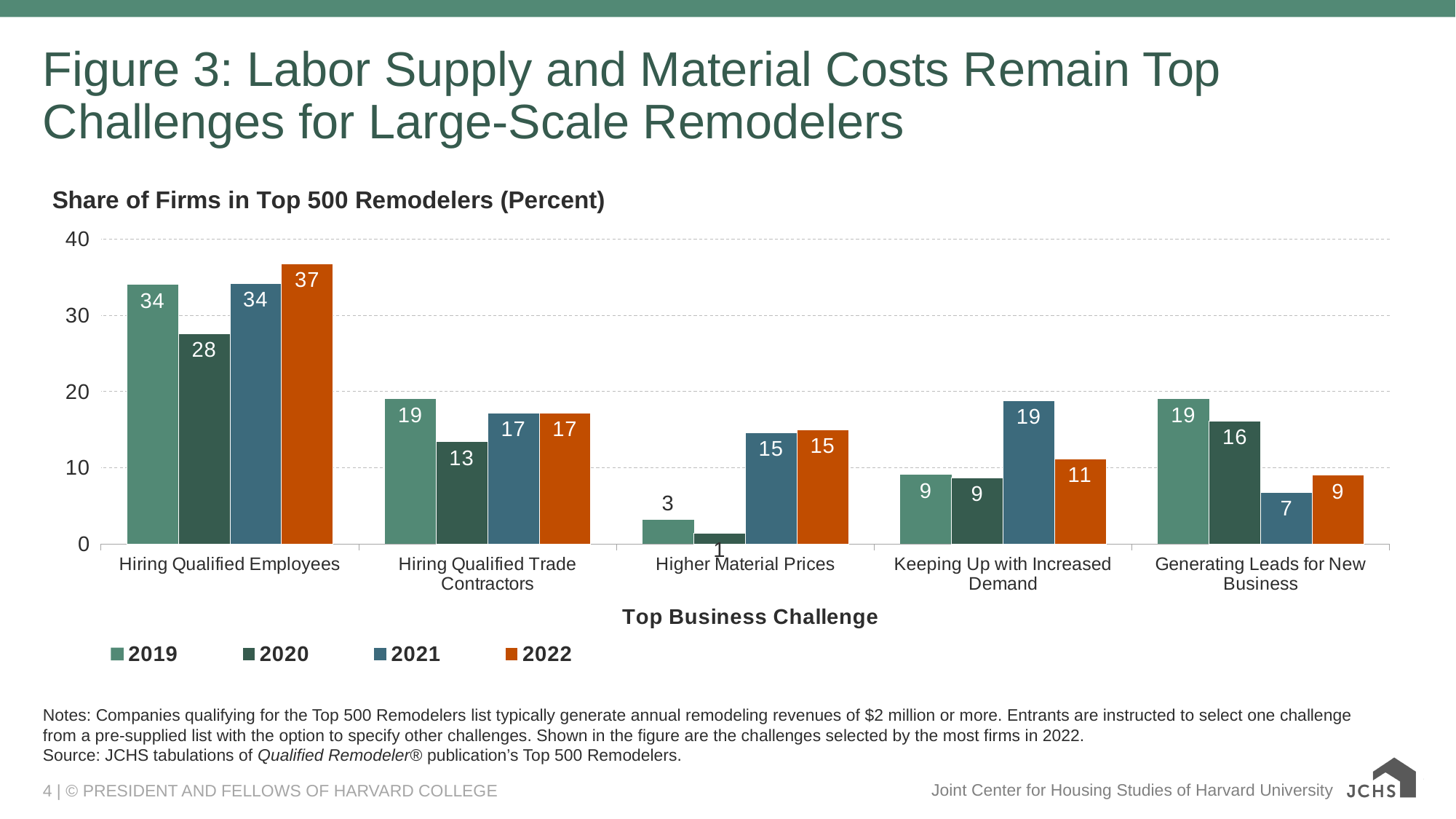
What is the 2020 value for Hiring Qualified Trade Contractors? 13 Which is larger for Generating Leads for New Business: the 2019 value or the 2021 value? 2019 What is the difference between the 2022 and 2020 values for Hiring Qualified Employees? 9 How many series does the legend list? 4 Which category has the highest 2022 value? Hiring Qualified Employees Is the 2021 value for Hiring Qualified Employees greater or less than 30? greater What is the 2019 value for Higher Material Prices? 3 Which category has the lowest 2020 value? Higher Material Prices What is the 2022 value for Hiring Qualified Employees? 37 How many categories are shown on the x axis? 5 What kind of chart is shown on the slide? bar chart What is the 2021 value for Keeping Up with Increased Demand? 19